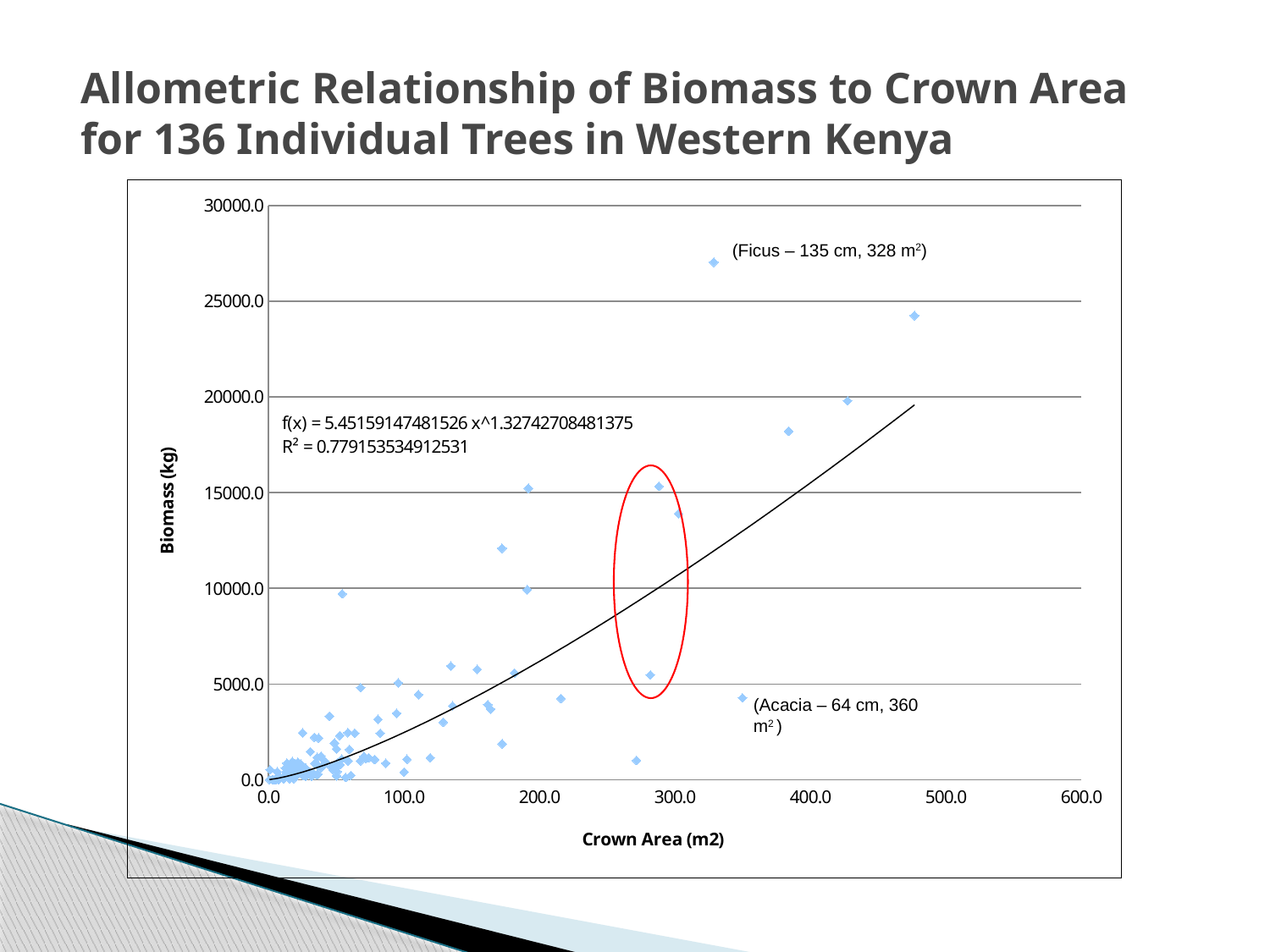
What crown area is given in the annotation for the Ficus tree? 328 m² Is the biomass of the annotated Ficus point greater or less than 25000.0 kg? greater Is the biomass of the annotated Acacia point greater or less than 5000.0 kg? less What is the title of the chart? Allometric Relationship of Biomass to Crown Area for 136 Individual Trees in Western Kenya How many individual trees does the chart title say are plotted? 136 Does biomass generally rise or fall as crown area increases along the x axis? rise What kind of chart is shown on the slide? scatter chart Which annotated tree has the higher biomass, the Ficus or the Acacia? Ficus What is the label of the vertical axis? Biomass (kg) What crown area is given in the annotation for the Acacia tree? 360 m² What R² value is printed on the chart for the trendline? 0.779153534912531 What is the highest value shown on the Crown Area axis? 600.0